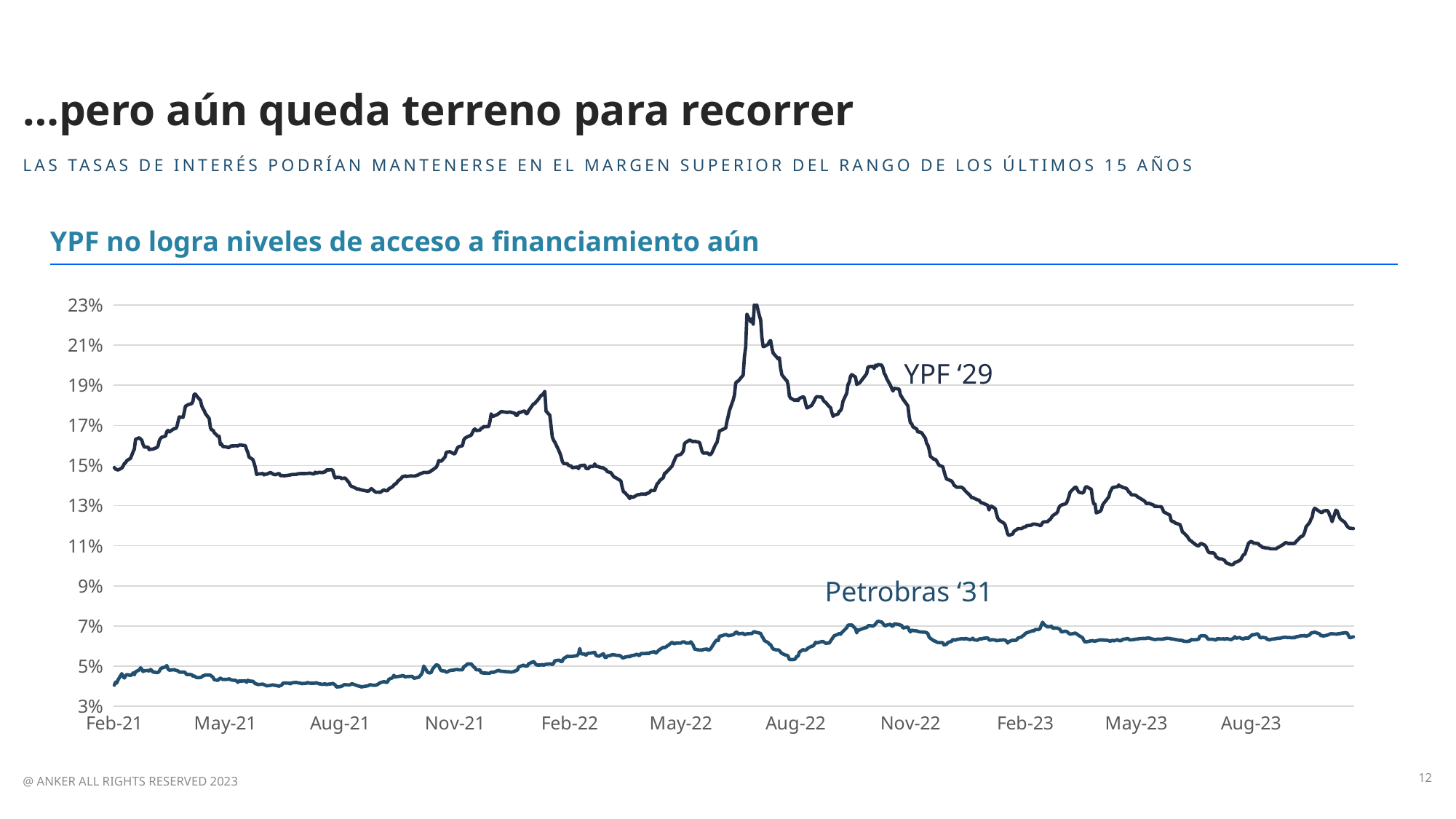
What are the names of the two series labelled on the chart? YPF '29 and Petrobras '31 Which series reaches the highest value on the chart? YPF '29 Is the peak value of YPF '29 greater or less than 21%? greater How many date labels are shown on the x axis? 11 Which series has the lowest values throughout the chart? Petrobras '31 What kind of chart is shown on the slide? line chart Is the value for YPF '29 at Aug-23 greater or less than 13%? less Is the value for Petrobras '31 at Feb-21 greater or less than 5%? less How many series are plotted on the chart? 2 At Feb-21, which series has the larger value, YPF '29 or Petrobras '31? YPF '29 What is the title of the chart? YPF no logra niveles de acceso a financiamiento aún Does the Petrobras '31 series rise or fall overall from Feb-21 to Aug-23? rise